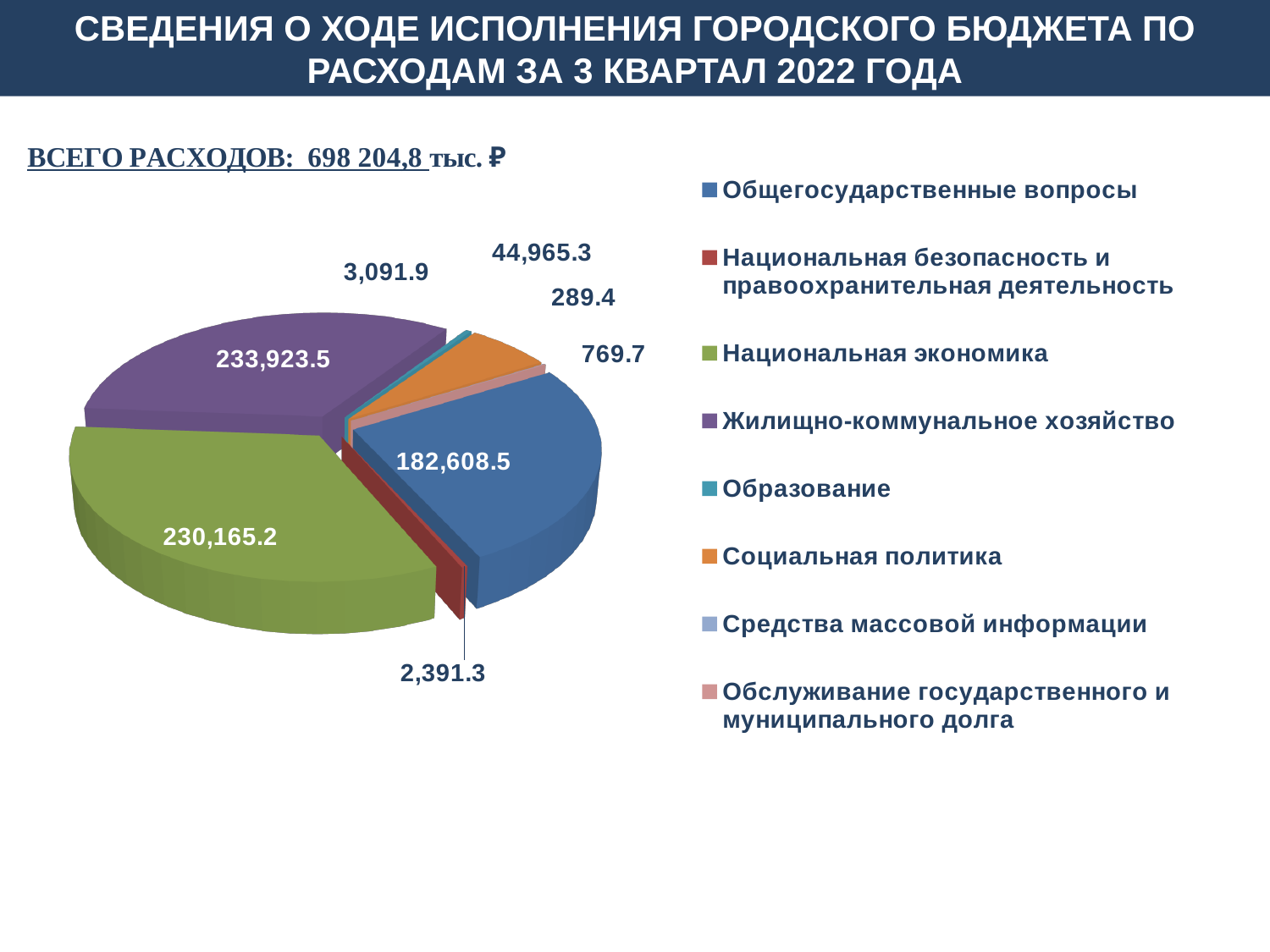
How many categories does the legend of the pie chart list? 8 Which category has the largest value in the pie chart? Жилищно-коммунальное хозяйство What total expenditure amount is stated on the slide? 698 204,8 тыс. ₽ What kind of chart is shown on the slide? pie chart What is the value for Жилищно-коммунальное хозяйство? 233,923.5 What is the value for Социальная политика? 44,965.3 What is the value for Общегосударственные вопросы? 182,608.5 What colour is the slice for Национальная экономика? green Which category has the smallest value in the pie chart? Средства массовой информации What is the difference between the values for Национальная экономика and Общегосударственные вопросы? 47,556.7 What is the value for Национальная безопасность и правоохранительная деятельность? 2,391.3 Which is larger: the value for Социальная политика or the value for Образование? Социальная политика